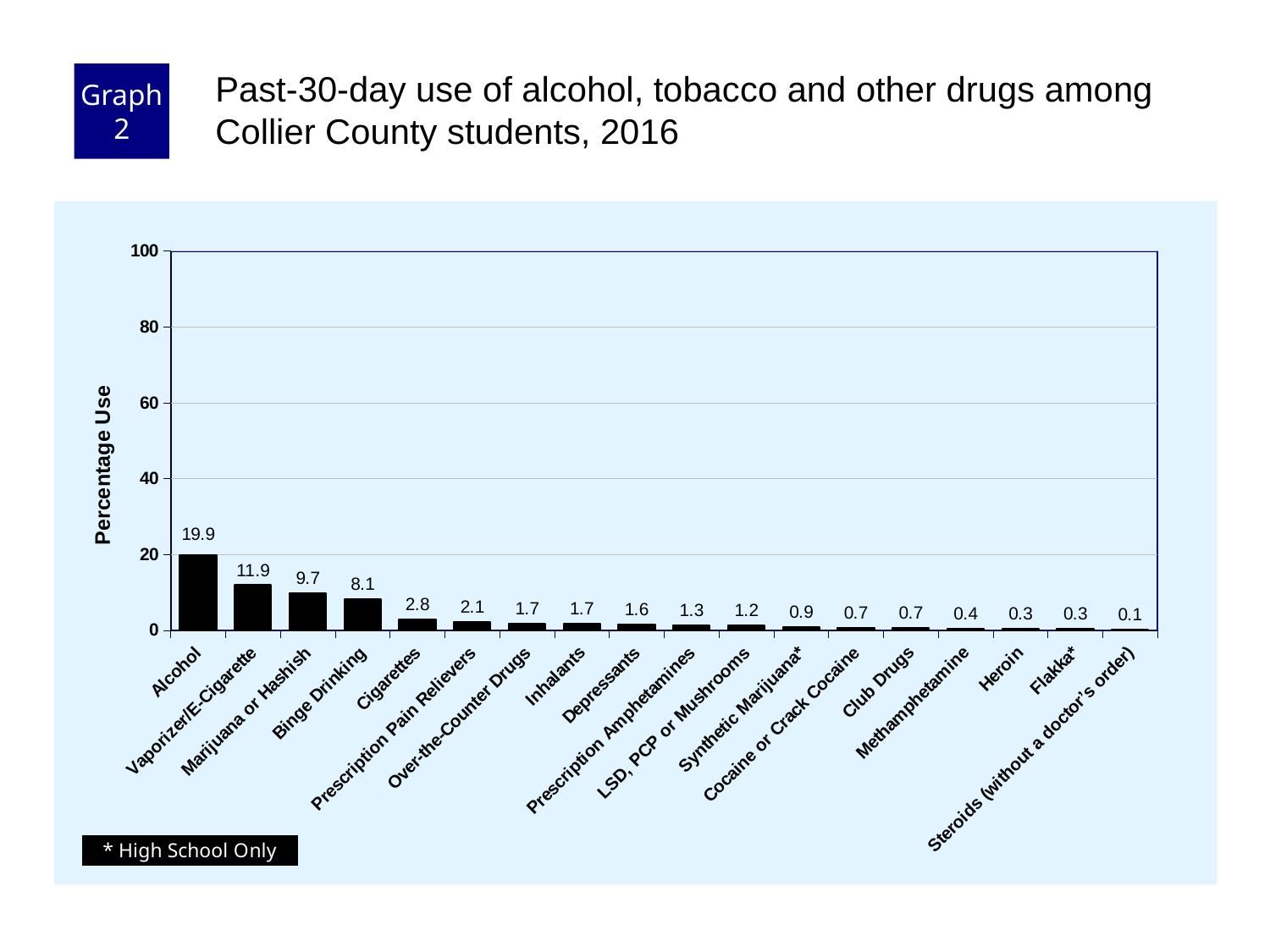
Which category has the highest percentage use? Alcohol What is the difference between the values for Alcohol and Vaporizer/E-Cigarette? 8.0 What kind of chart is shown on the slide? bar chart What is the percentage use value for Cigarettes? 2.8 What is the percentage use value for Methamphetamine? 0.4 What is the label of the y axis? Percentage Use What is the percentage use value for Alcohol? 19.9 Is the value for Alcohol greater or less than 20? less Which is larger, the value for Marijuana or Hashish or the value for Binge Drinking? Marijuana or Hashish How many categories are shown on the x axis? 18 Which category has the lowest percentage use? Steroids (without a doctor's order) What is the percentage use value for Binge Drinking? 8.1